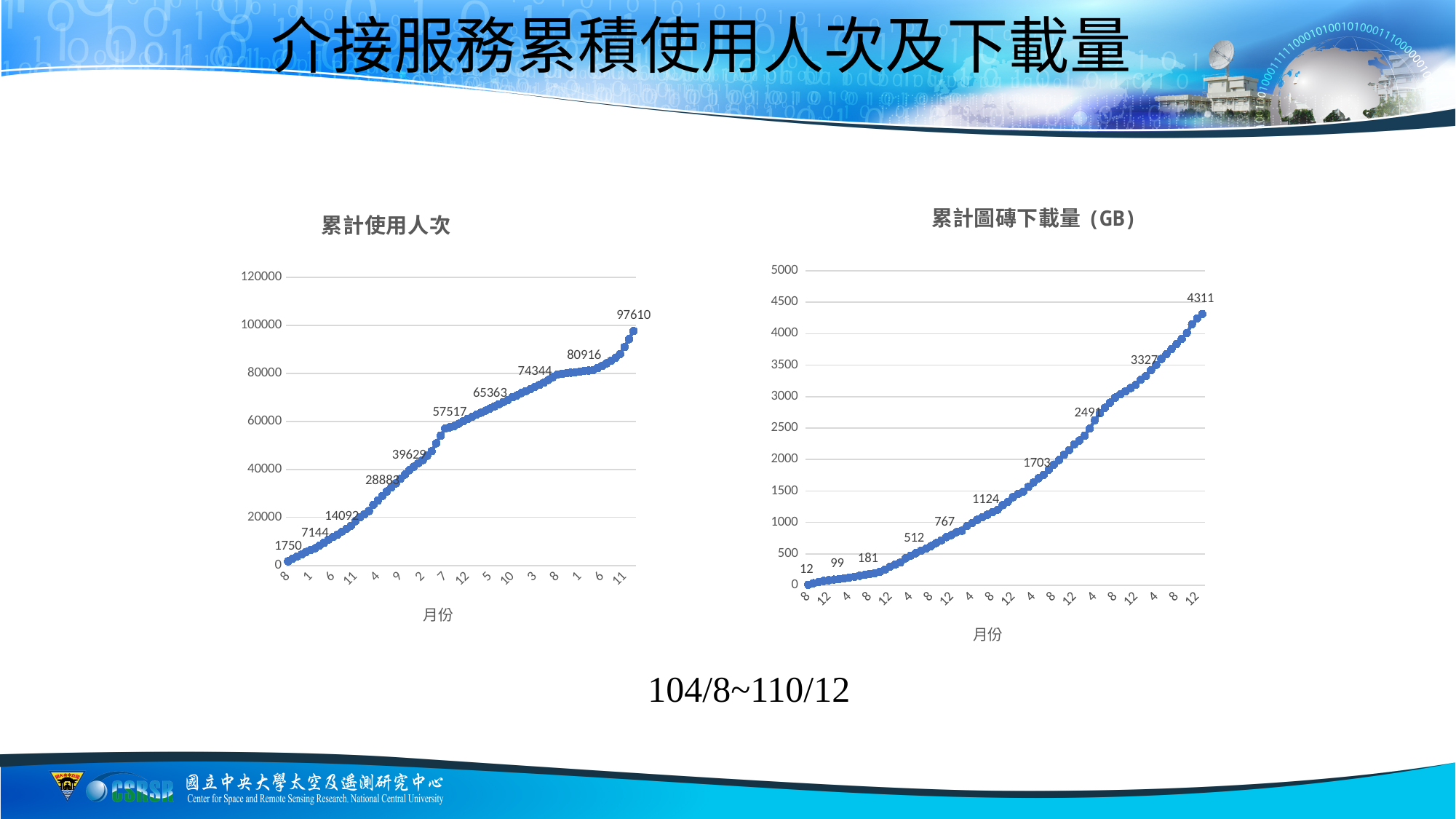
What is the x-axis label of the right chart (累計圖磚下載量（GB）)? 月份 In the right chart (累計圖磚下載量（GB）), what is the lowest labeled value? 12 In the right chart (累計圖磚下載量（GB）), what is the highest labeled value? 4311 What kind of chart is the left chart titled 累計使用人次? line chart In the left chart (累計使用人次), what is the lowest labeled value? 1750 In the left chart (累計使用人次), is the final value greater or less than 80000? greater In the left chart (累計使用人次), what is the difference between the labeled values 97610 and 80916? 16694 In the left chart (累計使用人次), what is the highest labeled value? 97610 In the right chart (累計圖磚下載量（GB）), is the final value greater or less than 4500? less In the right chart (累計圖磚下載量（GB）), do the values rise or fall along the x axis? rise In the left chart (累計使用人次), which is larger: the labeled value 57517 or 65363? 65363 In the right chart (累計圖磚下載量（GB）), what is the difference between the labeled values 4311 and 3327? 984